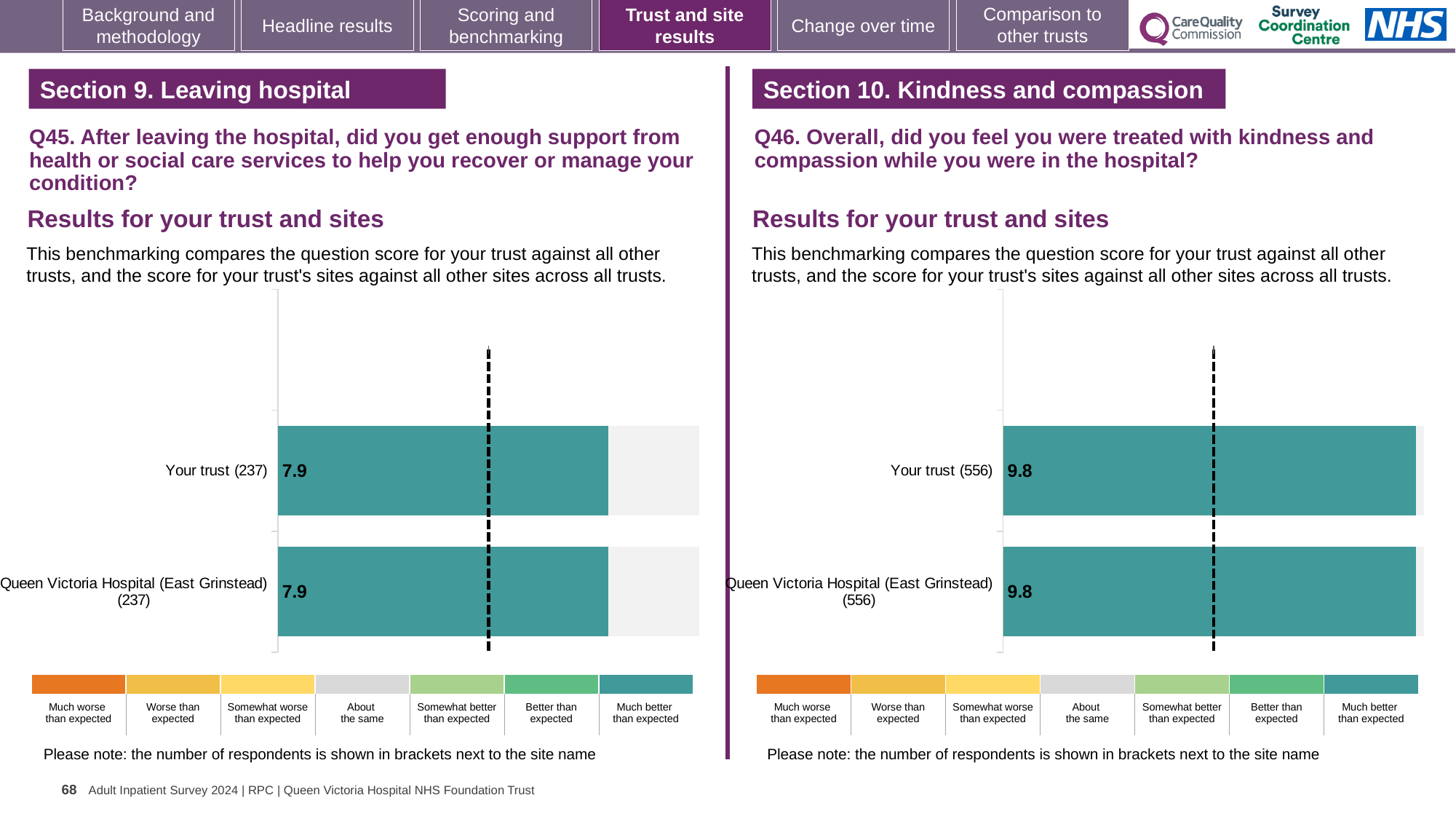
According to the legend, which benchmark category does the colour of the bars in the Q46 chart on the right represent? Much better than expected How many categories does the colour legend below the Q45 chart on the left list? 7 In the Q45 chart on the left, what is the score for Your trust? 7.9 How many bars are plotted in the Q45 chart on the left? 2 How many respondents are shown in brackets for Your trust in the Q46 chart on the right? 556 In the Q45 chart on the left, what is the difference between the score for Your trust and the score for Queen Victoria Hospital (East Grinstead)? 0 In the Q46 chart on the right, what is the score for Your trust? 9.8 In the Q46 chart on the right, what is the score for Queen Victoria Hospital (East Grinstead)? 9.8 How many bars are plotted in the Q46 chart on the right? 2 In the Q45 chart on the left, what is the score for Queen Victoria Hospital (East Grinstead)? 7.9 What kind of chart is used for the Q45 results on the left? Bar chart In the Q46 chart on the right, what is the difference between the score for Your trust and the score for Queen Victoria Hospital (East Grinstead)? 0